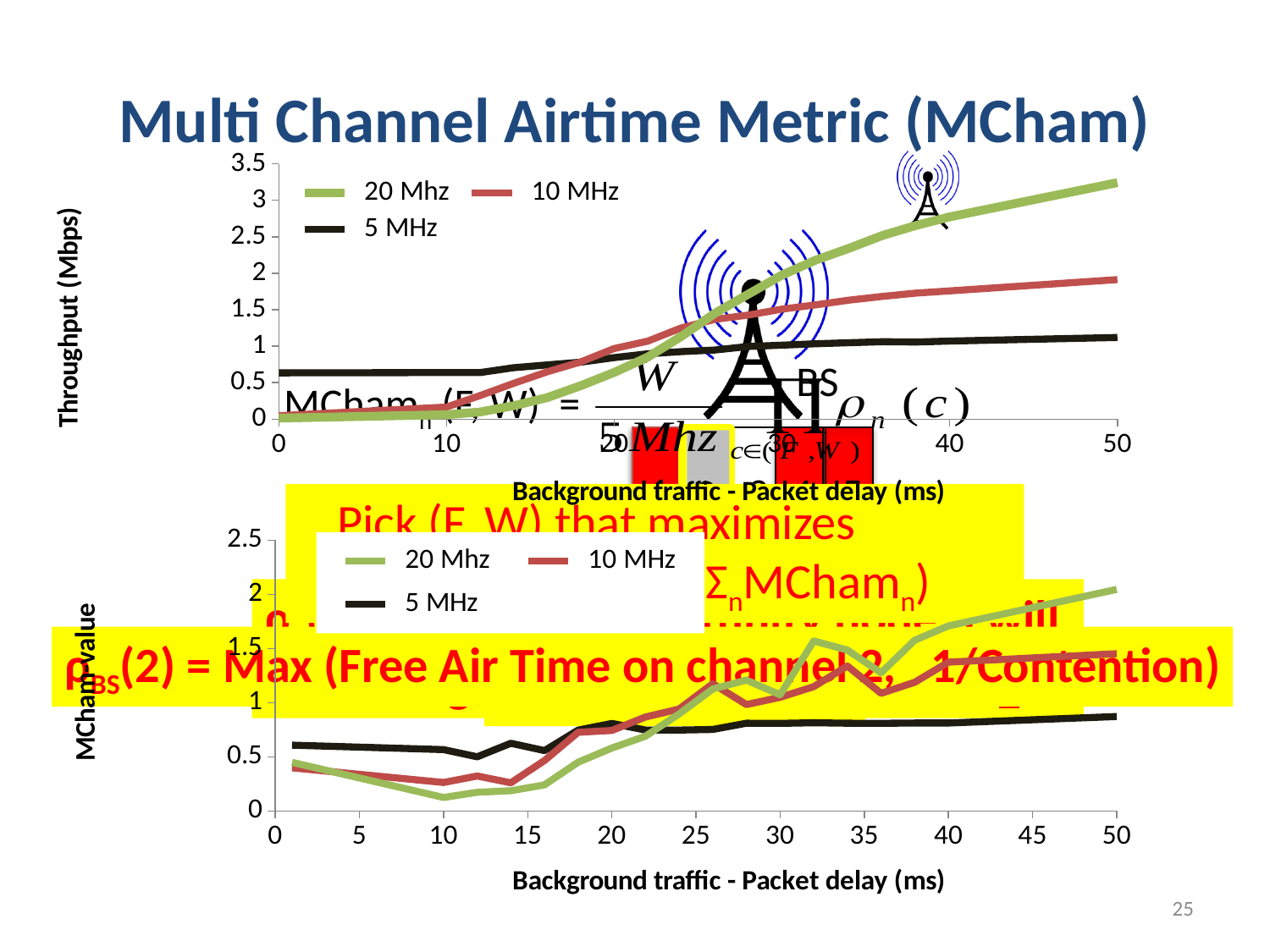
How many series does the legend of the top chart list? 3 In the bottom chart, at a packet delay of 10 ms, which series has the higher MCham-value: 5 MHz or 20 Mhz? 5 MHz In the top chart, does the throughput of the 20 Mhz series rise or fall as packet delay increases from 0 to 50 ms? rise What is the y-axis label of the bottom chart? MCham-value In the bottom chart, is the MCham-value of the 5 MHz series at 50 ms greater or less than 1? less In the top chart, is the throughput of the 10 MHz series at 50 ms greater or less than 2? less In the top chart, which series has the highest throughput at a packet delay of 50 ms? 20 Mhz In the top chart, at a packet delay of 0 ms, which series has the higher throughput: 5 MHz or 20 Mhz? 5 MHz What type of chart is the top chart (Throughput vs Background traffic - Packet delay)? line chart In the bottom chart, is the MCham-value of the 20 Mhz series at 50 ms greater or less than 1.5? greater In the top chart, which series has the lowest throughput at a packet delay of 50 ms? 5 MHz